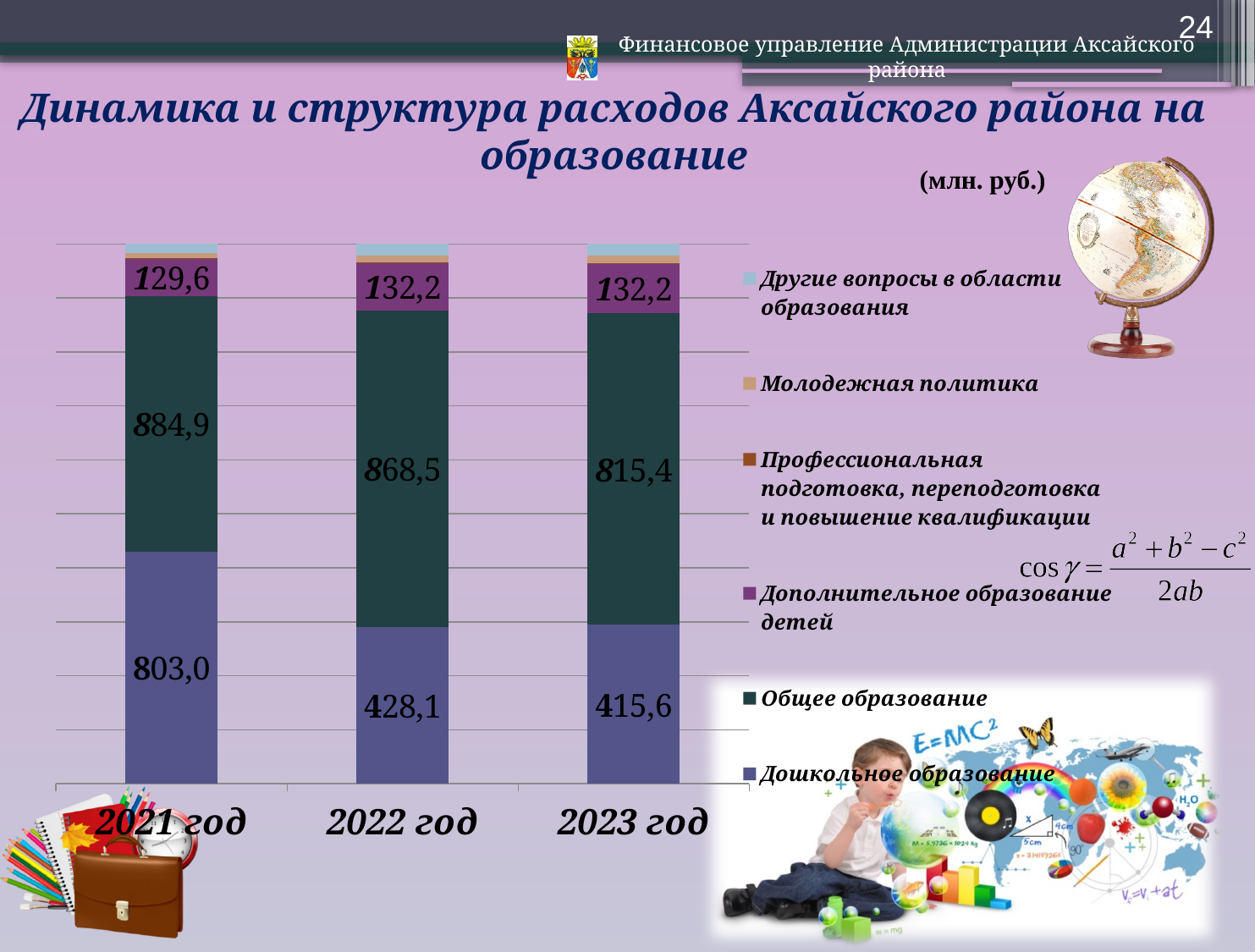
What is the value for Дополнительное образование детей in 2023 год? 132,2 What unit is stated for the chart values? млн. руб. What is the value for Общее образование in 2022 год? 868,5 What is the value for Дошкольное образование in 2022 год? 428,1 What is the value for Дошкольное образование in 2021 год? 803,0 What is the value for Общее образование in 2023 год? 815,4 What kind of chart is shown on the slide? Stacked bar chart What is the difference between the Дополнительное образование детей values for 2022 год and 2021 год? 2,6 Do the Дошкольное образование values rise or fall from 2021 год to 2023 год? Fall How many years are shown on the x axis? 3 How many series does the legend list? 6 What is the difference between the Дошкольное образование values for 2022 год and 2023 год? 12,5